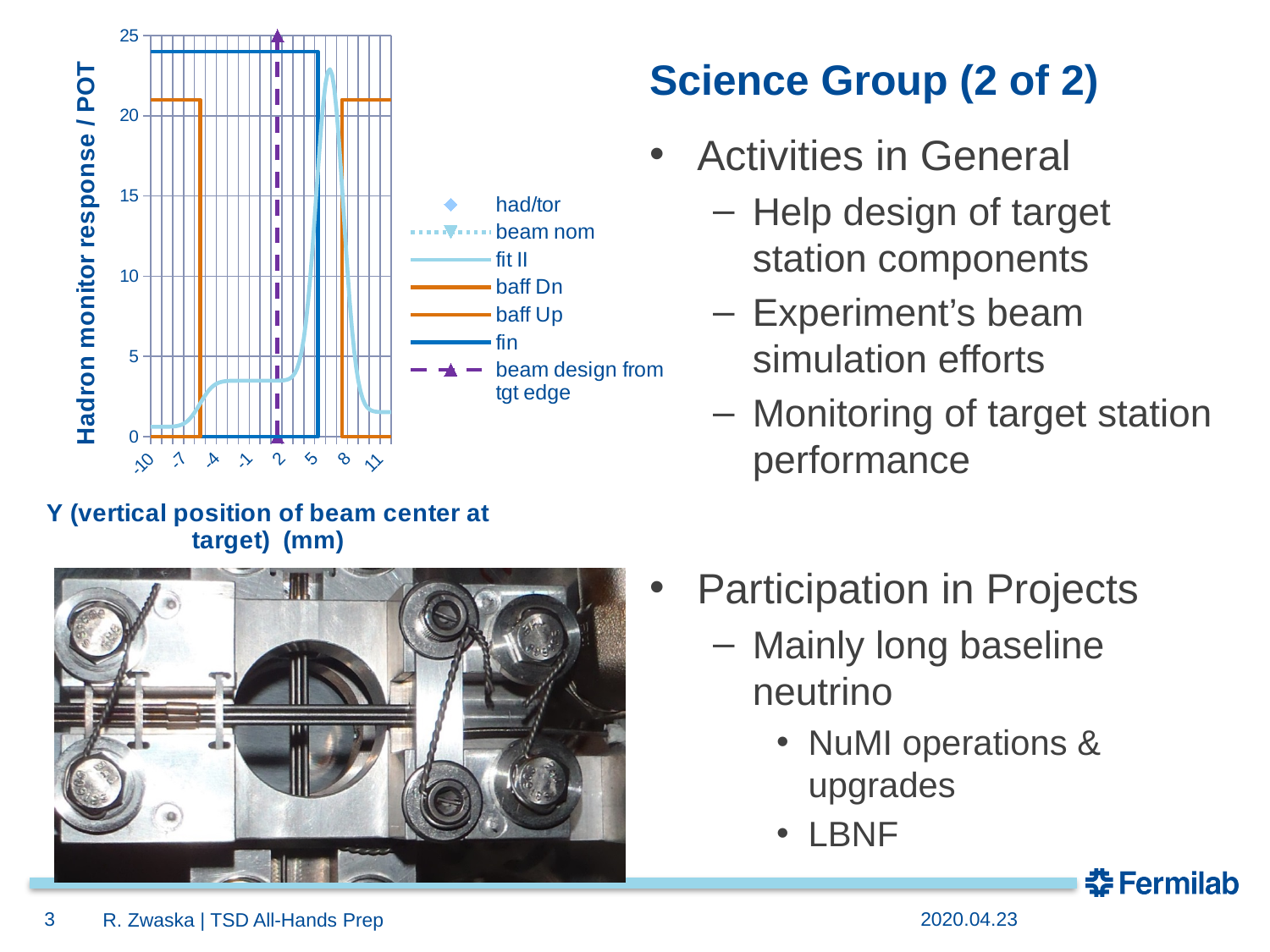
What kind of chart is shown on the slide? line chart Is the peak value of the 'fit II' series greater or less than 20? greater Is the flat top of the 'fin' series greater or less than 20? greater What is the maximum value shown on the chart's vertical axis? 25 What is the lowest tick label on the chart's horizontal axis? -10 What is the title of the chart's horizontal axis? Y (vertical position of beam center at target) (mm) Is the value of the 'fit II' series at x = -10 greater or less than 5? less What is the highest tick label on the chart's horizontal axis? 11 How many tick labels are shown on the chart's horizontal axis? 8 How many series does the chart's legend list? 7 What is the title of the chart's vertical axis? Hadron monitor response / POT Which legend entry is listed last in the chart's legend? beam design from tgt edge